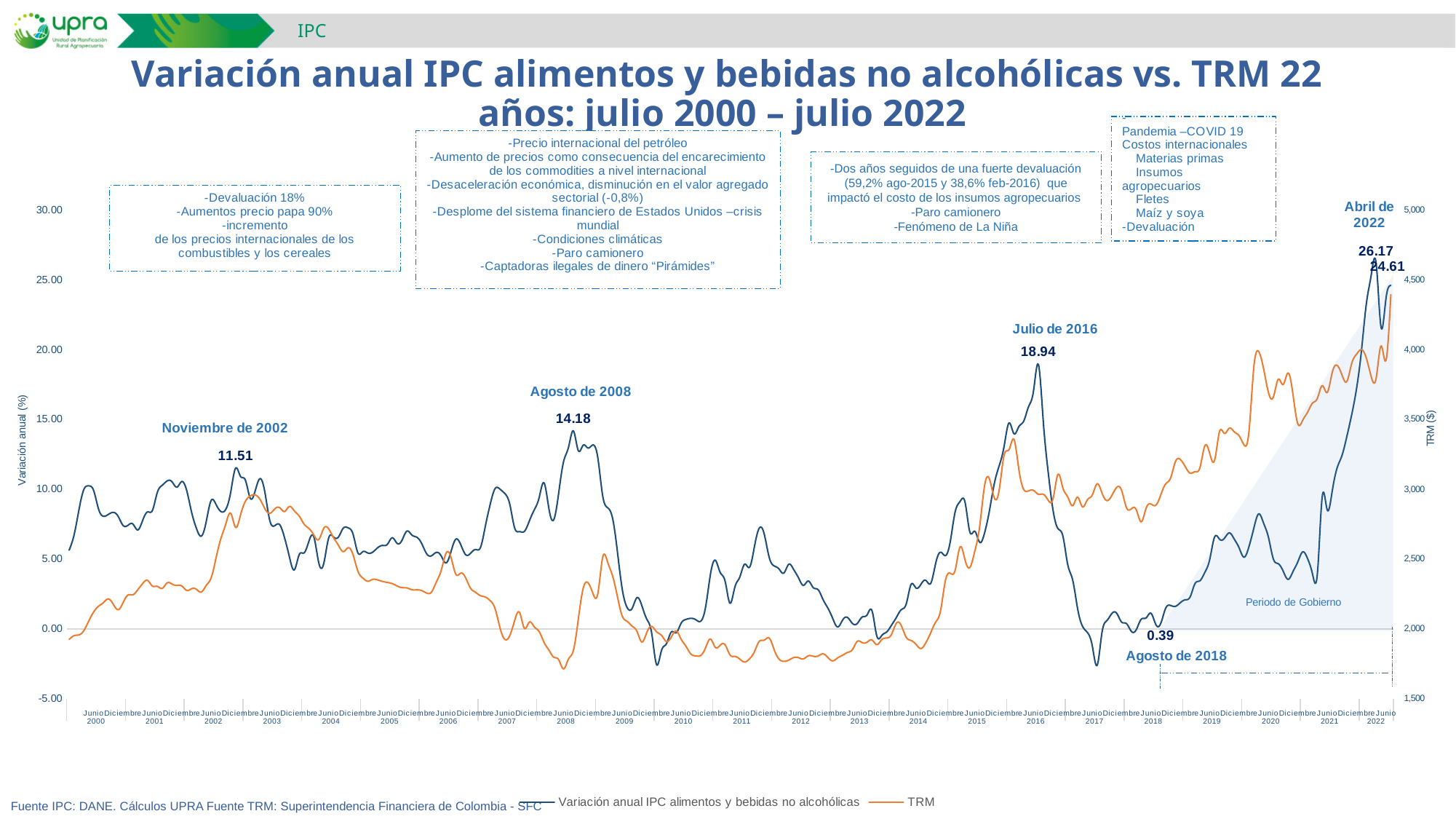
Is the TRM value at the end of the series in 2022 greater or less than 4,000? greater Which of the labelled peaks of the annual IPC variation is the highest? Abril de 2022 What is the label of the right-hand vertical axis? TRM ($) What is the labelled value of the annual IPC variation for Julio de 2016? 18.94 What is the labelled value of the annual IPC variation for Agosto de 2008? 14.18 How many series does the legend list? 2 What is the labelled value of the annual IPC variation for Agosto de 2018? 0.39 Which labelled IPC value is larger, Noviembre de 2002 or Agosto de 2008? Agosto de 2008 What is the labelled value of the annual IPC variation for Abril de 2022? 26.17 What is the labelled value of the annual IPC variation for Noviembre de 2002? 11.51 What is the difference between the labelled IPC values for Julio de 2016 and Agosto de 2008? 4.76 What kind of chart is shown on the slide? line chart